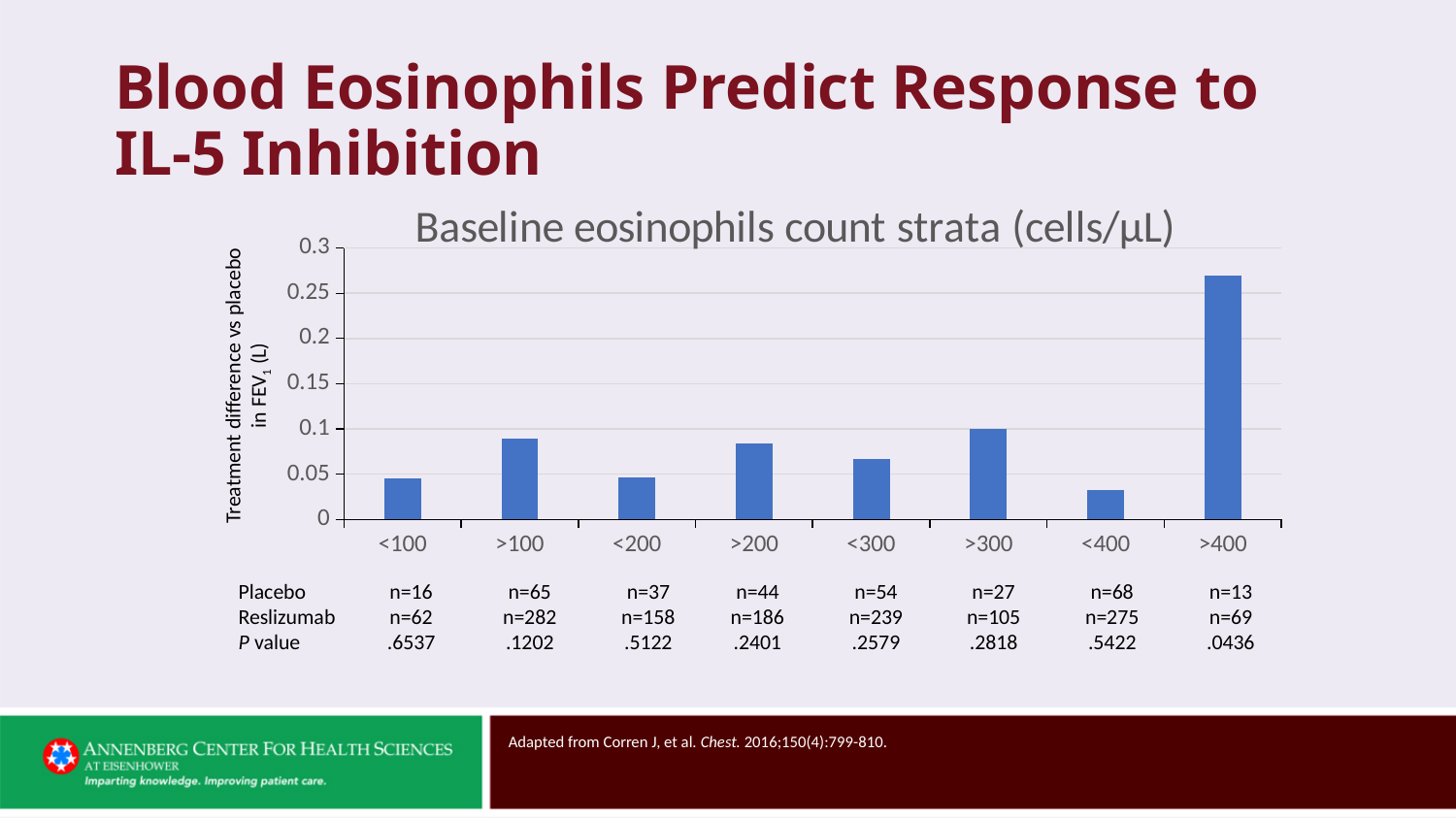
How many baseline eosinophil count strata are plotted on the x axis? 8 Which baseline eosinophil stratum has the lowest treatment difference vs placebo in FEV1? <400 Is the treatment difference for the >400 stratum greater or less than 0.25? greater What kind of chart is shown on the slide? bar chart Is the treatment difference for the >100 stratum greater or less than 0.05? greater What is the label on the y axis of the chart? Treatment difference vs placebo in FEV1 (L) Is the treatment difference for the >200 stratum greater or less than 0.1? less Which baseline eosinophil stratum has the highest treatment difference vs placebo in FEV1? >400 What is the title of the chart? Baseline eosinophils count strata (cells/µL) Which has the larger treatment difference vs placebo, the <300 stratum or the >300 stratum? >300 Which has the larger treatment difference vs placebo, the <100 stratum or the >100 stratum? >100